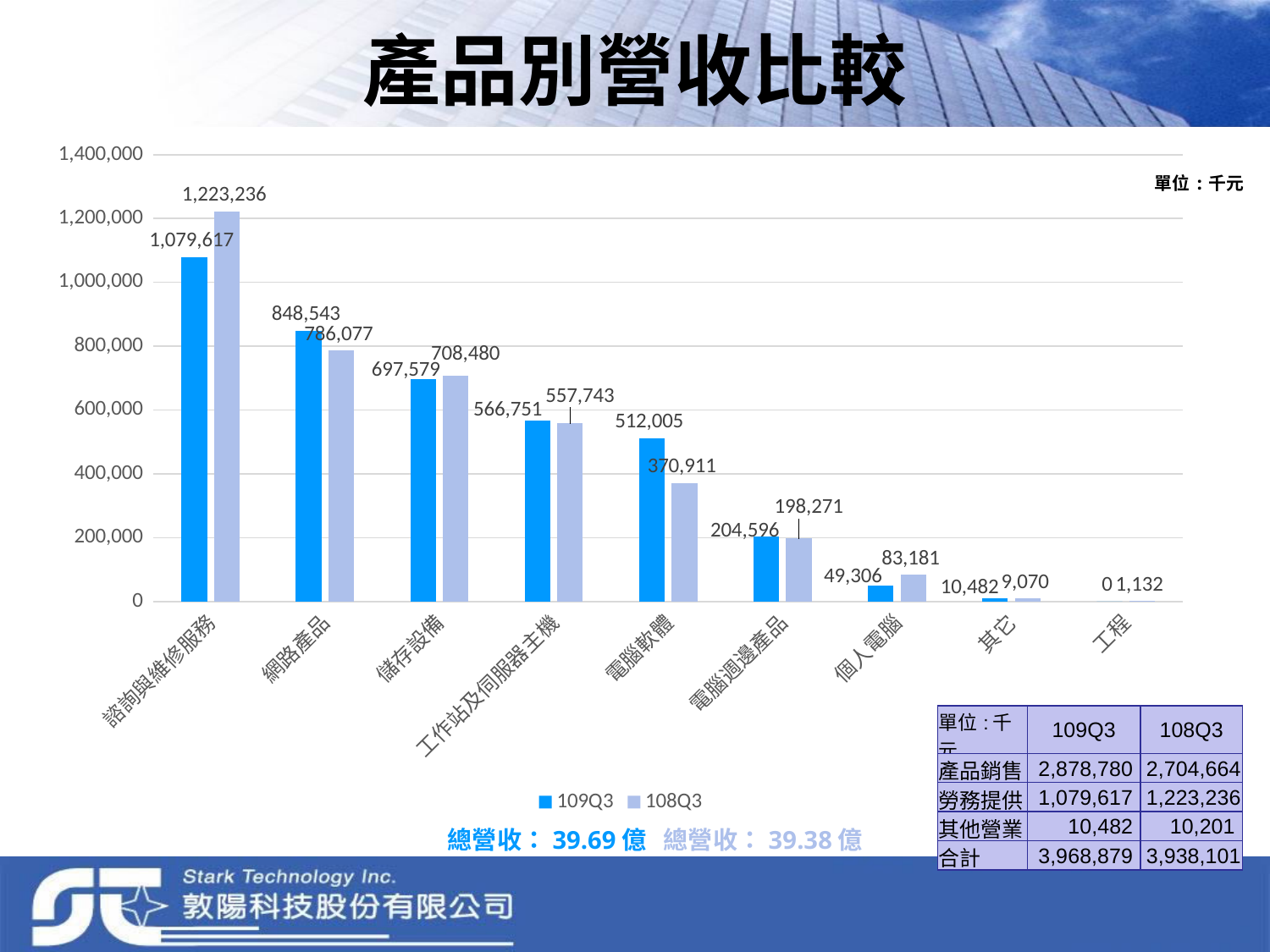
What is the 109Q3 value for 諮詢與維修服務? 1,079,617 What is the 108Q3 value for 電腦軟體? 370,911 Which category has the lowest 109Q3 value? 工程 What is the 109Q3 value for 個人電腦? 49,306 Which category has the highest 108Q3 value? 諮詢與維修服務 What is the difference between the 108Q3 and 109Q3 values for 諮詢與維修服務? 143,619 What kind of chart is shown on the slide? Bar chart For 個人電腦, which is larger: the 109Q3 value or the 108Q3 value? 108Q3 For 網路產品, which is larger: the 109Q3 value or the 108Q3 value? 109Q3 How many categories are shown on the x axis of the chart? 9 What is the difference between the 109Q3 and 108Q3 values for 電腦軟體? 141,094 How many series does the chart legend list? 2